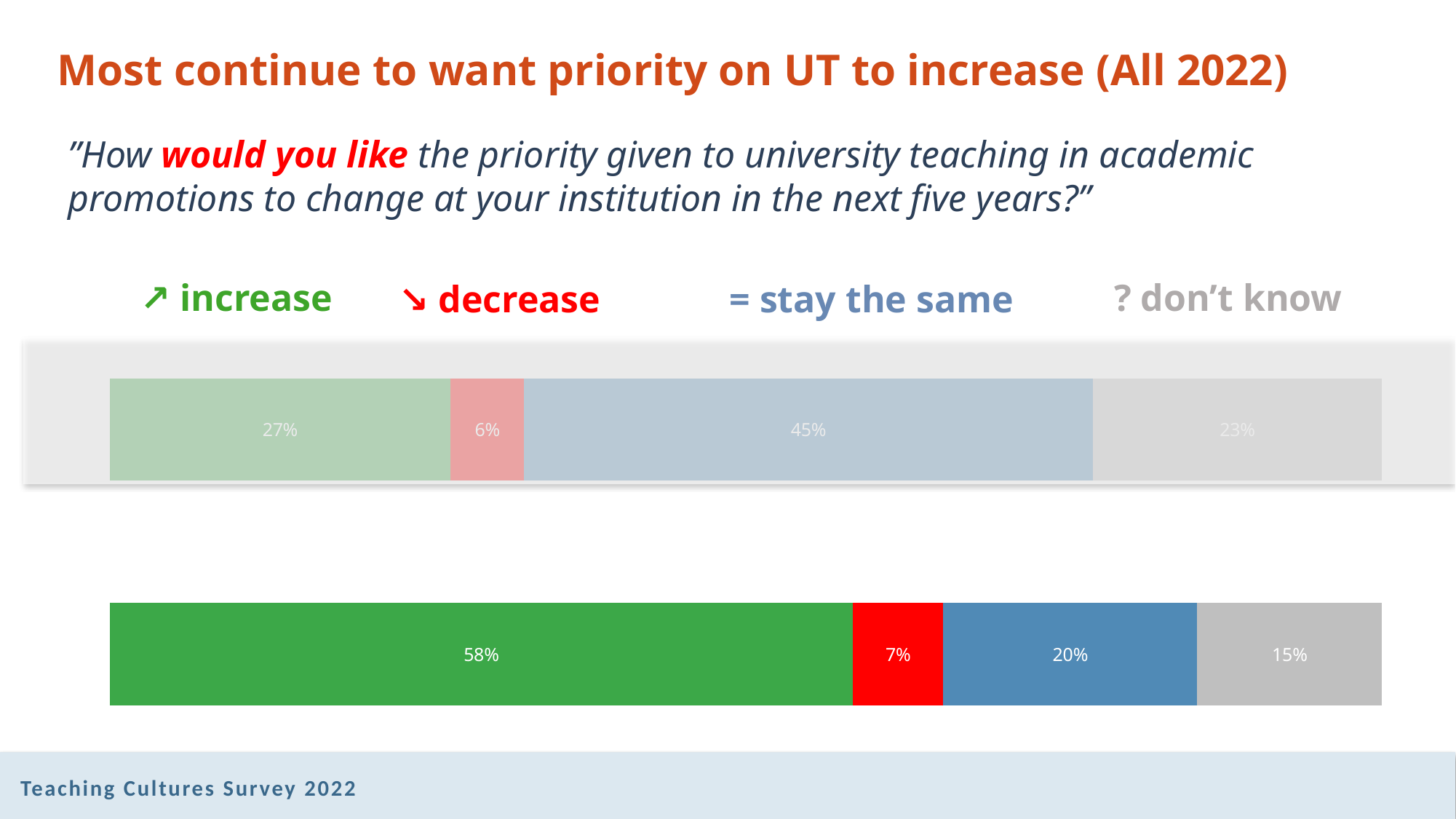
In the upper (faded) bar, what percentage is shown for the "stay the same" segment? 45% In the upper (faded) bar, which is larger: the "increase" segment or the "don't know" segment? increase What colour represents the "stay the same" category in the bars? blue In the lower (bottom) bar, what is the difference between the "increase" and "stay the same" percentages? 38 percentage points In the lower (bottom) bar, which response category has the smallest share? decrease In the lower (bottom) bar, which response category has the largest share? increase In the lower (bottom) bar, what percentage chose "stay the same"? 20% In the lower (bottom) bar, what percentage of respondents chose "increase"? 58% How many response categories does the legend list? 4 In the lower (bottom) bar, what percentage chose "don't know"? 15% In the lower (bottom) bar, what percentage chose "decrease"? 7% In the upper (faded) bar, what percentage is shown for the "increase" segment? 27%